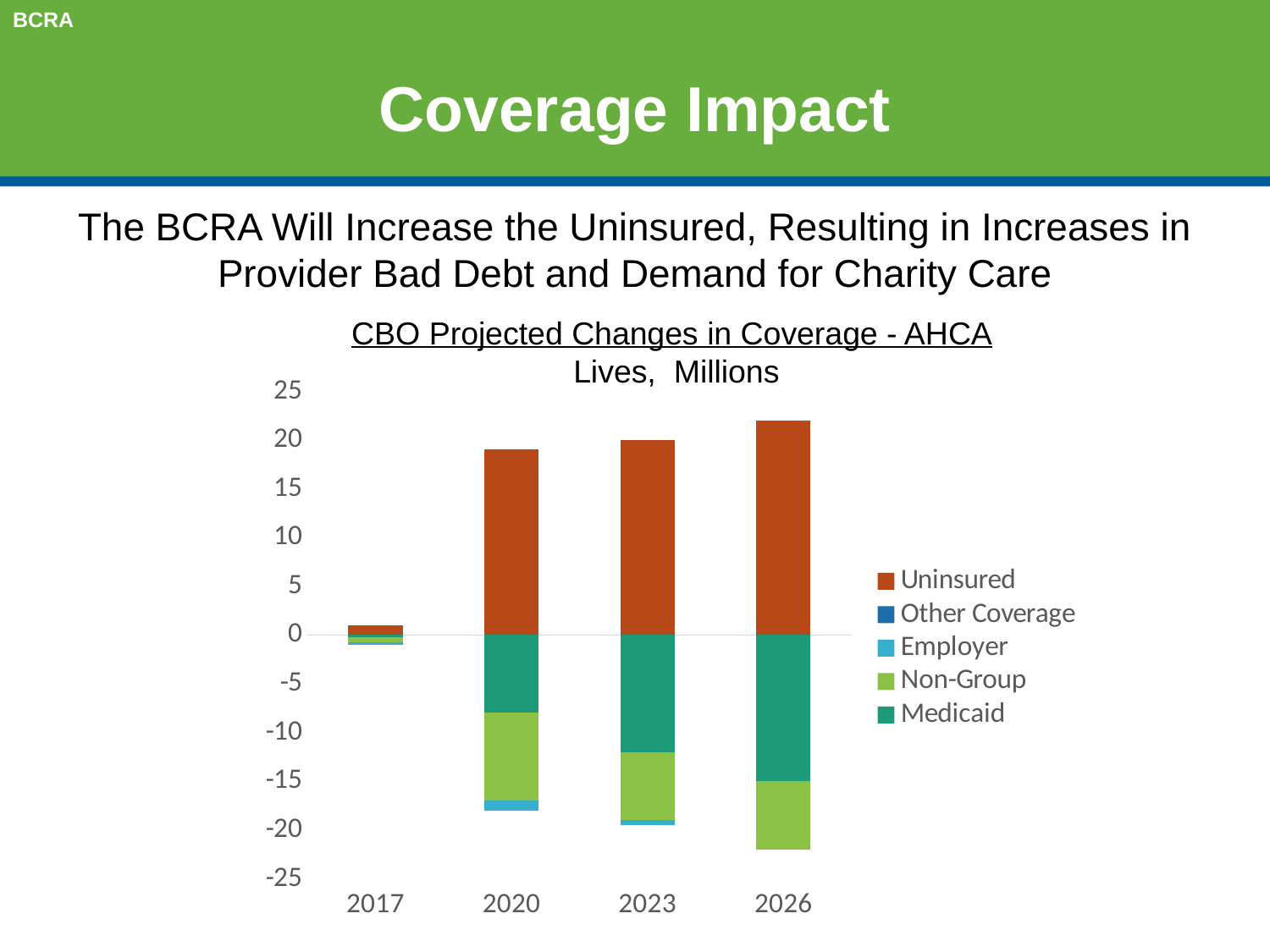
Is the Uninsured value for 2017 greater or less than 5? less In what units are the values on the chart expressed, according to the chart subtitle? Lives, Millions Which year has the largest Uninsured value? 2026 How many series does the chart's legend list? 5 Does the Uninsured value rise or fall from 2017 to 2026? rise How many years are shown on the x axis of the chart? 4 Which year has the smallest Uninsured value? 2017 What is the title of the chart? CBO Projected Changes in Coverage - AHCA What kind of chart is shown on the slide? Stacked bar chart Which year has a larger Uninsured value, 2020 or 2026? 2026 Is the Uninsured value for 2020 greater or less than 15? greater Is the Uninsured value for 2026 greater or less than 20? greater